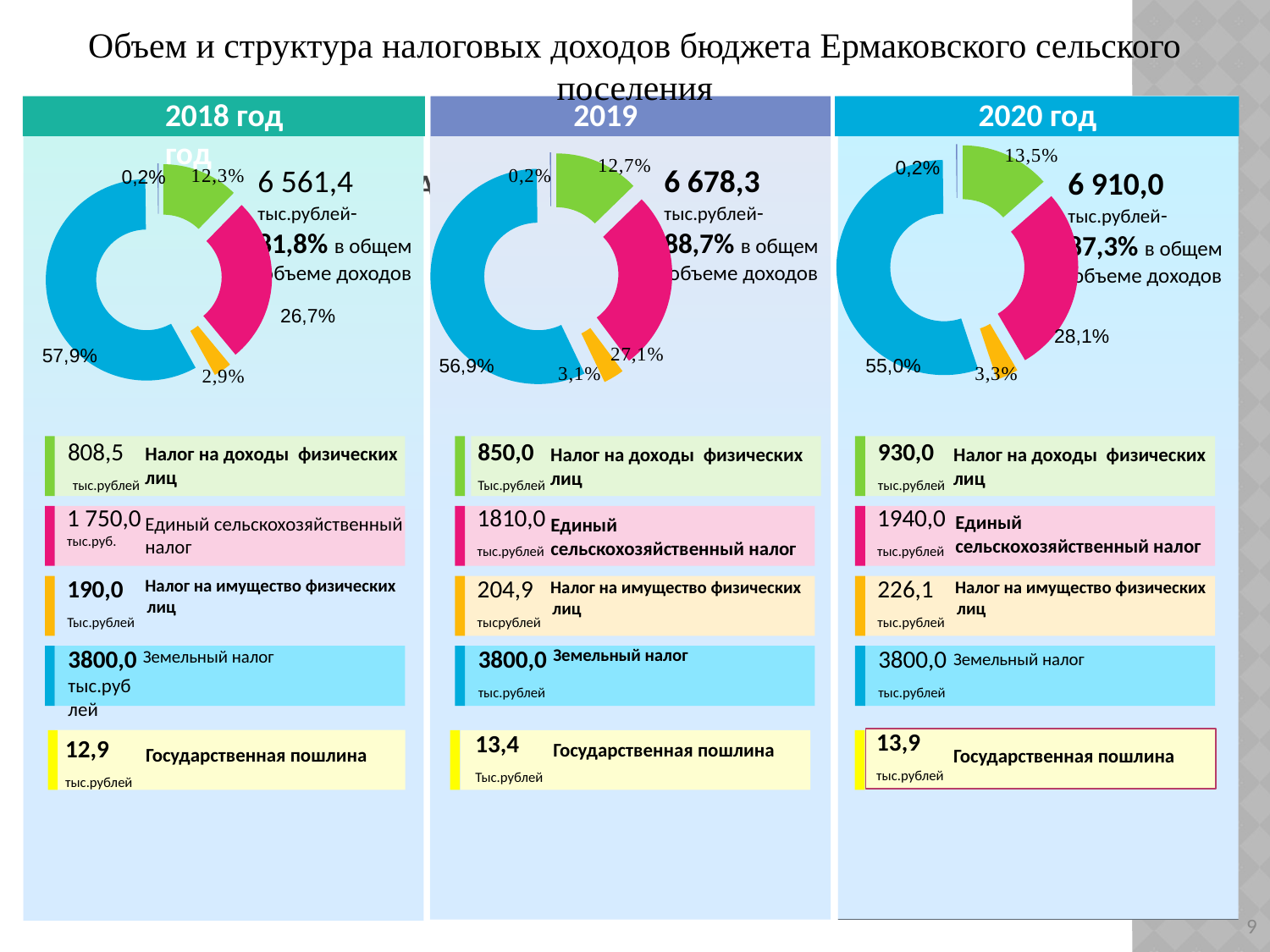
In the 2018 год chart, what is the smallest slice's share? 0,2% In the 2019 год chart, what share is shown for the green slice (Налог на доходы физических лиц)? 12,7% What total in тыс.рублей is printed next to the 2020 год chart? 6 910,0 How many slices does the 2019 год chart have? 5 In the 2018 год chart, what is the largest slice's share? 57,9% In the 2019 год chart, what share is shown for the blue slice (Земельный налог)? 56,9% What kind of chart is shown for 2018 год? Doughnut (pie) chart In the 2018 год chart, what is the difference between the blue slice (57,9%) and the pink slice (26,7%)? 31,2% Across the 2018, 2019 and 2020 charts, does the share of the largest (blue) slice rise or fall? Fall (57,9% → 56,9% → 55,0%) In the 2019 год chart, which is larger: the green slice (12,7%) or the orange slice (3,1%)? The green slice (12,7%) In the 2020 год chart, what share is shown for the orange slice (Налог на имущество физических лиц)? 3,3% In the 2020 год chart, what share is shown for the pink slice (Единый сельскохозяйственный налог)? 28,1%